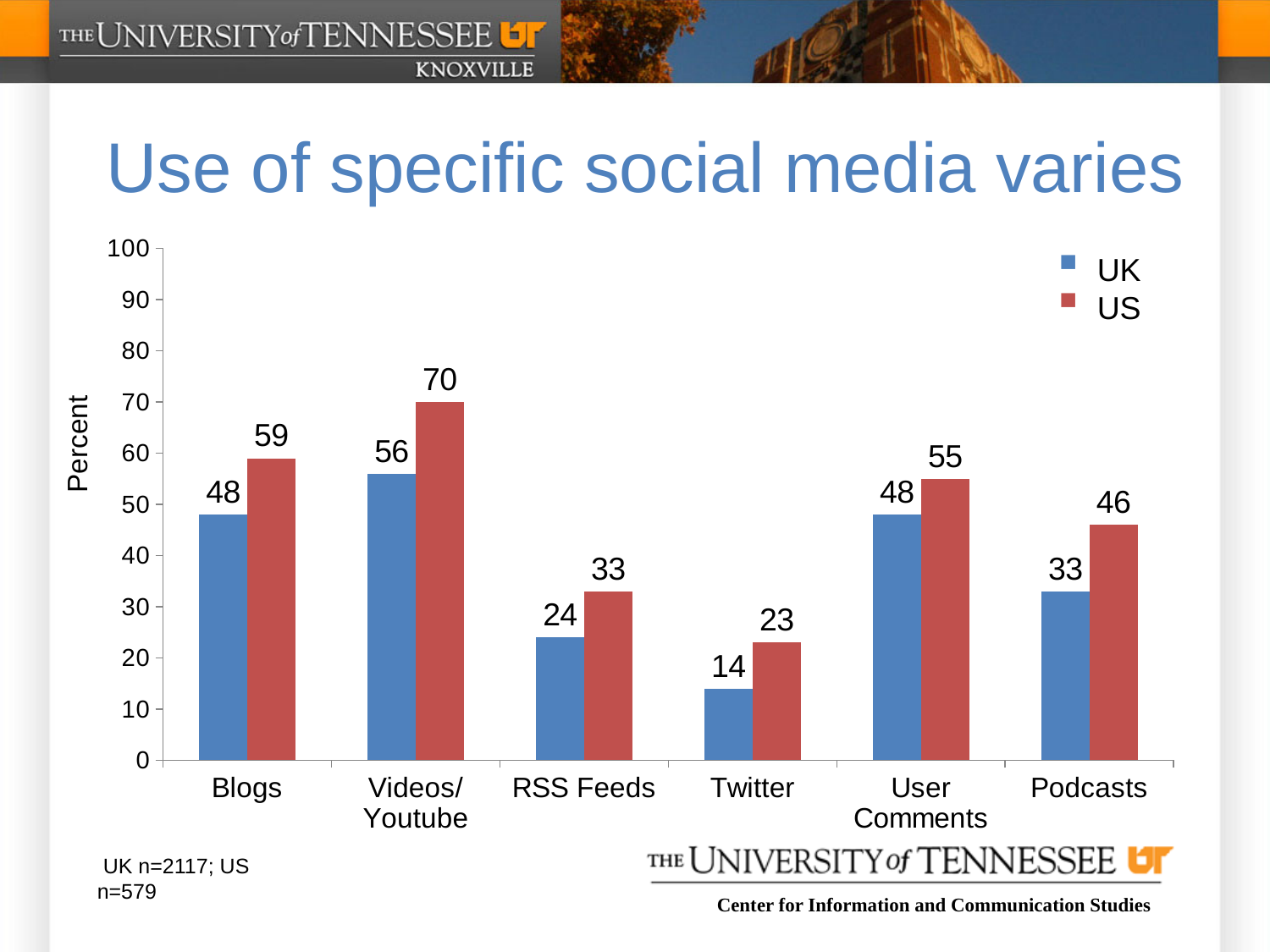
What kind of chart is shown on the slide? Bar chart Which is larger, the UK value for User Comments or the UK value for Podcasts? User Comments What is the US value for Videos/Youtube? 70 How many categories are shown on the x axis? 6 Which category has the highest US value? Videos/Youtube What is the label on the y axis? Percent What is the difference between the US and UK values for RSS Feeds? 9 Which category has the lowest UK value? Twitter What is the UK value for Twitter? 14 How many series does the legend list? 2 What is the UK value for Blogs? 48 What is the US value for Podcasts? 46